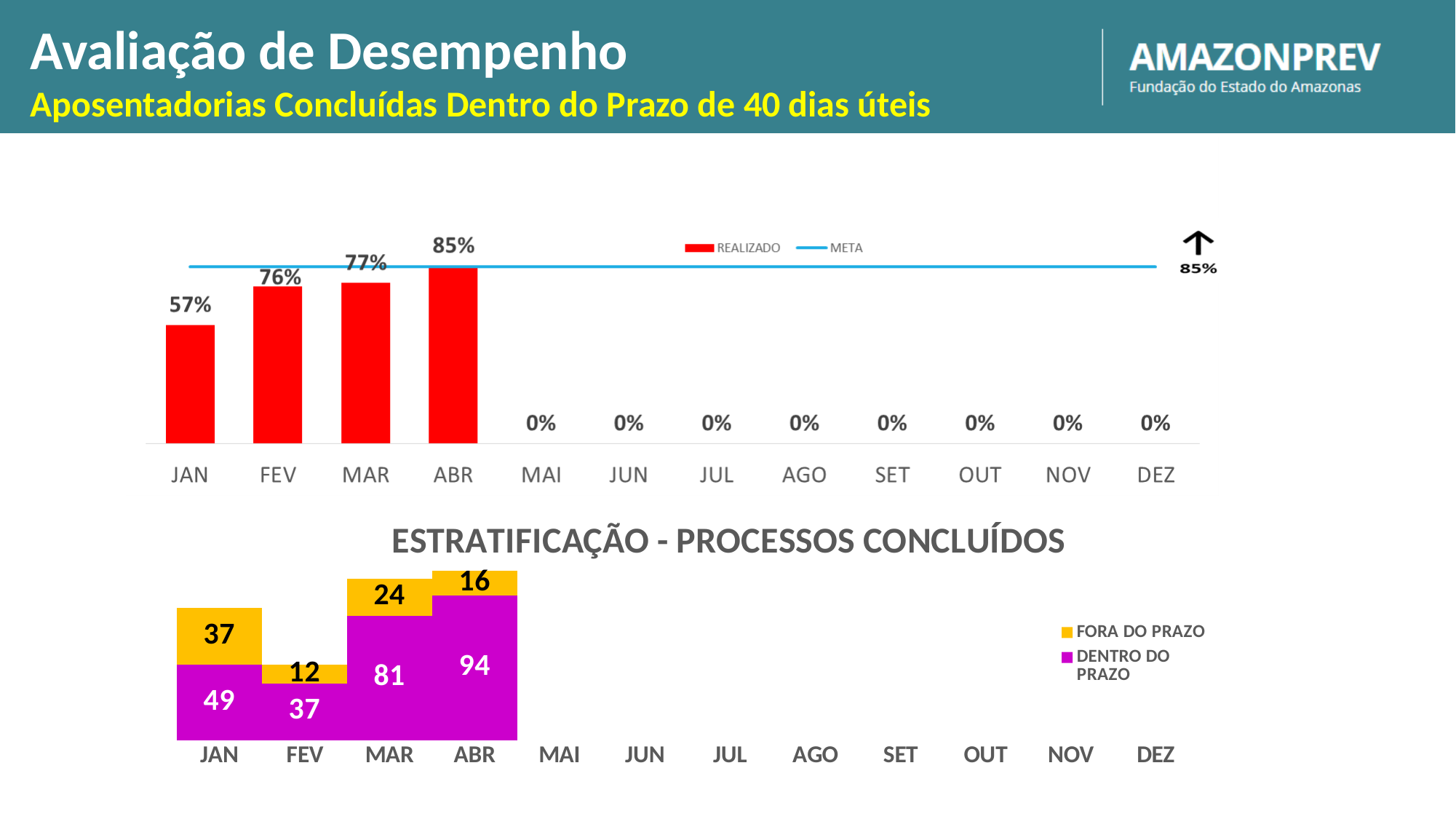
In the chart titled ESTRATIFICAÇÃO - PROCESSOS CONCLUÍDOS, which month has the highest FORA DO PRAZO value? JAN In the top chart, which month has the highest REALIZADO value? ABR In the top chart, what is the REALIZADO value for MAR? 77% In the top chart, what is the REALIZADO value for JAN? 57% In the chart titled ESTRATIFICAÇÃO - PROCESSOS CONCLUÍDOS, what is the FORA DO PRAZO value for FEV? 12 What kind of chart is the ESTRATIFICAÇÃO - PROCESSOS CONCLUÍDOS chart? stacked bar chart In the chart titled ESTRATIFICAÇÃO - PROCESSOS CONCLUÍDOS, what is the DENTRO DO PRAZO value for MAR? 81 In the chart titled ESTRATIFICAÇÃO - PROCESSOS CONCLUÍDOS, what is the total of the stacked bar for ABR? 110 In the top chart, what is the difference between the REALIZADO values for ABR and JAN? 28% In the top chart, how many series does the legend list? 2 In the top chart, do the REALIZADO values rise or fall from JAN to ABR? rise In the top chart, what is the META value shown? 85%